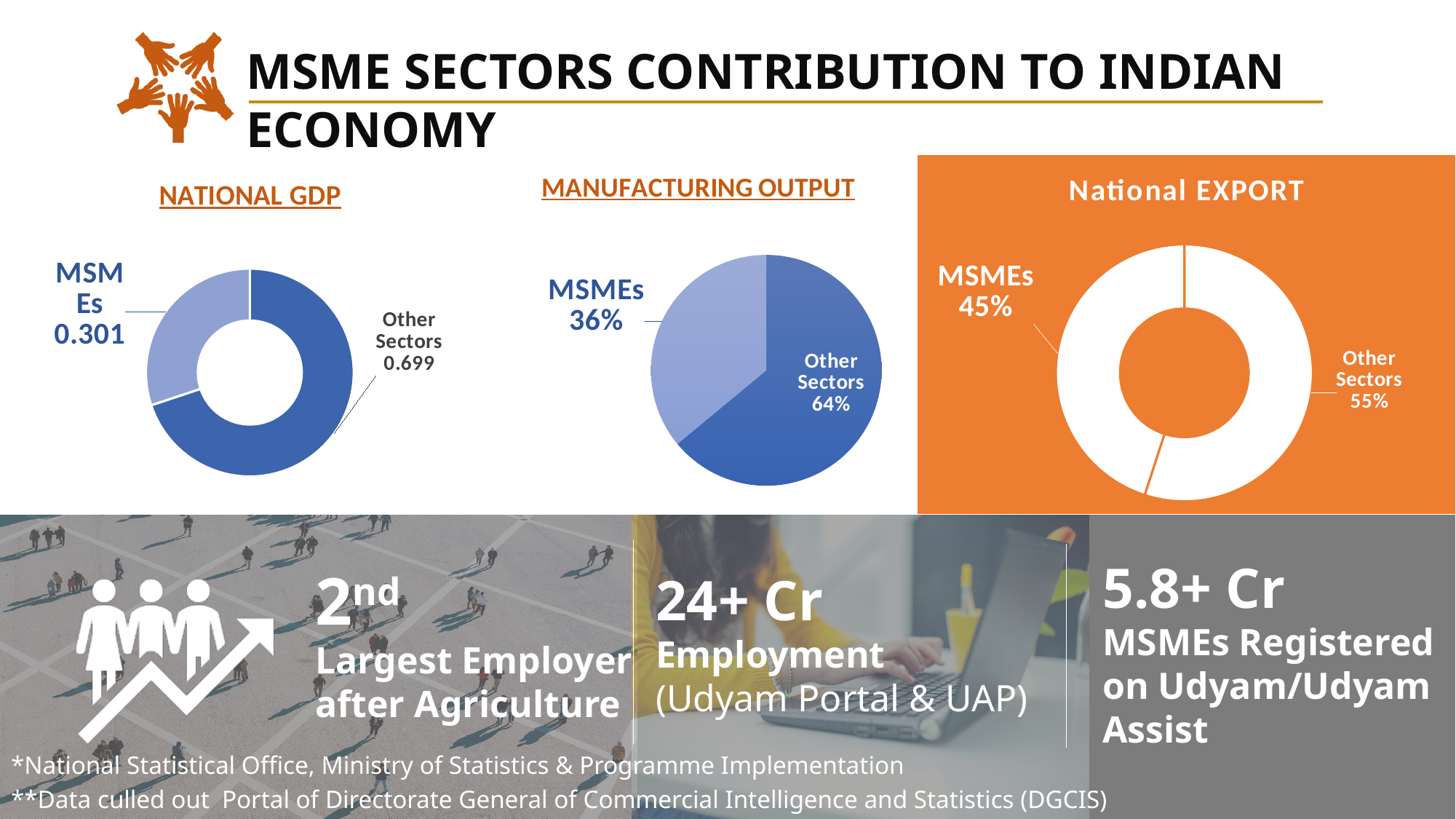
In the National GDP chart, what is the value for MSMEs? 0.301 In the National Export chart, which slice is larger, MSMEs or Other Sectors? Other Sectors In the National Export chart, what share do MSMEs hold? 45% In the National Export chart, what share do Other Sectors hold? 55% In the National GDP chart, what is the value for Other Sectors? 0.699 In the Manufacturing Output chart, what share do MSMEs hold? 36% What is the title of the chart on the orange background? National EXPORT What kind of chart is the Manufacturing Output chart? Pie chart How many slices does the National GDP chart have? 2 In the Manufacturing Output chart, what is the difference between the Other Sectors share and the MSMEs share? 28% In the Manufacturing Output chart, what share do Other Sectors hold? 64% In the National Export chart, what is the difference between the Other Sectors share and the MSMEs share? 10%